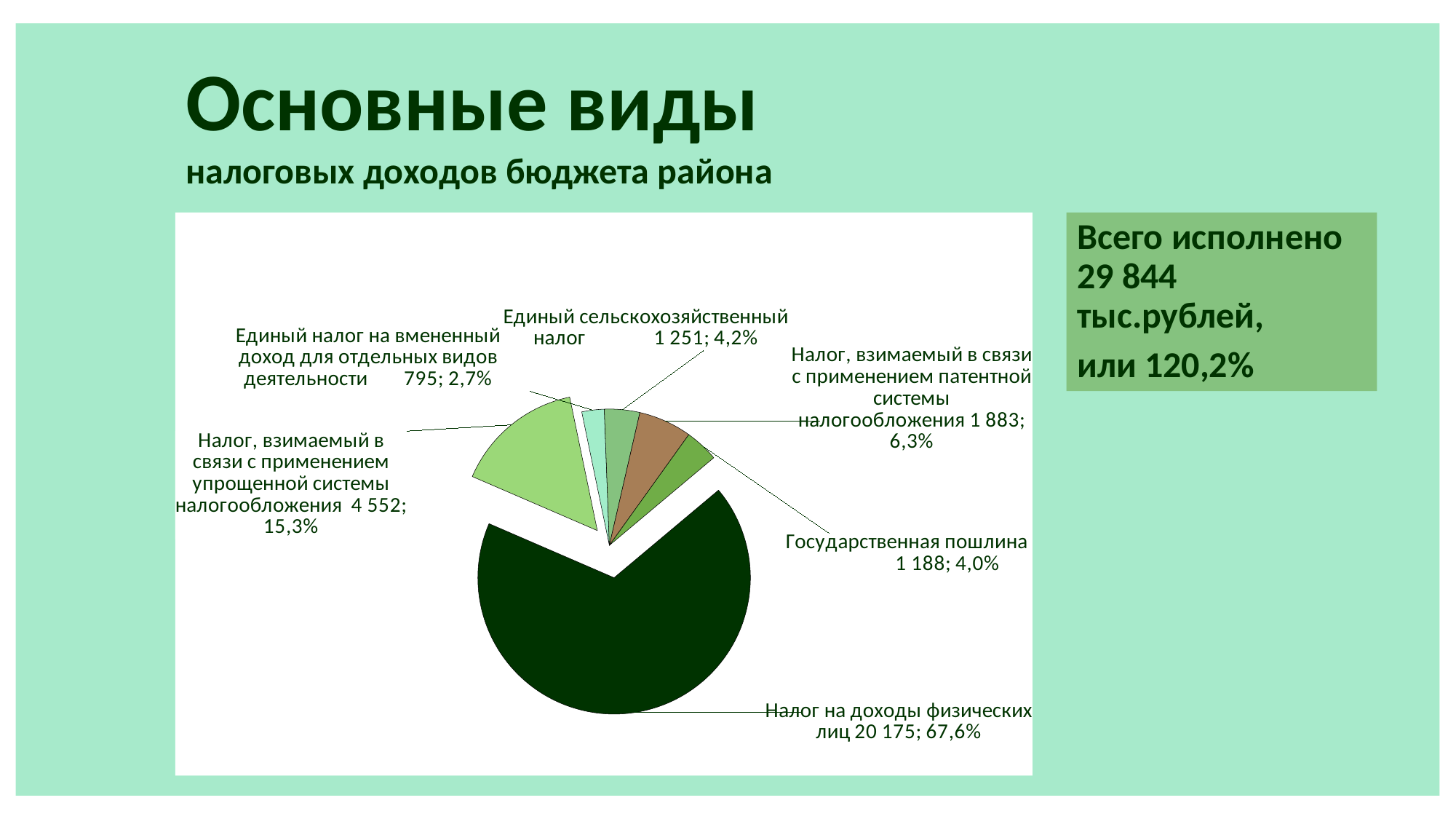
What is the value for Налог, взимаемый в связи с применением упрощенной системы налогообложения? 4 552 How many slices does the pie chart have? 6 Which category has the smallest slice of the pie? Единый налог на вмененный доход для отдельных видов деятельности What is the value for Единый сельскохозяйственный налог? 1 251 What share of the pie does Налог на доходы физических лиц represent? 67,6% What is the value for Налог на доходы физических лиц? 20 175 What is the difference between the values for Налог, взимаемый в связи с применением патентной системы налогообложения and Государственная пошлина? 695 Which is larger: the value for Единый сельскохозяйственный налог or the value for Единый налог на вмененный доход для отдельных видов деятельности? Единый сельскохозяйственный налог Which category has the largest slice of the pie? Налог на доходы физических лиц What is the total of all slice values in the pie chart? 29 844 What share of the pie does Государственная пошлина represent? 4,0% What type of chart is shown on the slide? pie chart